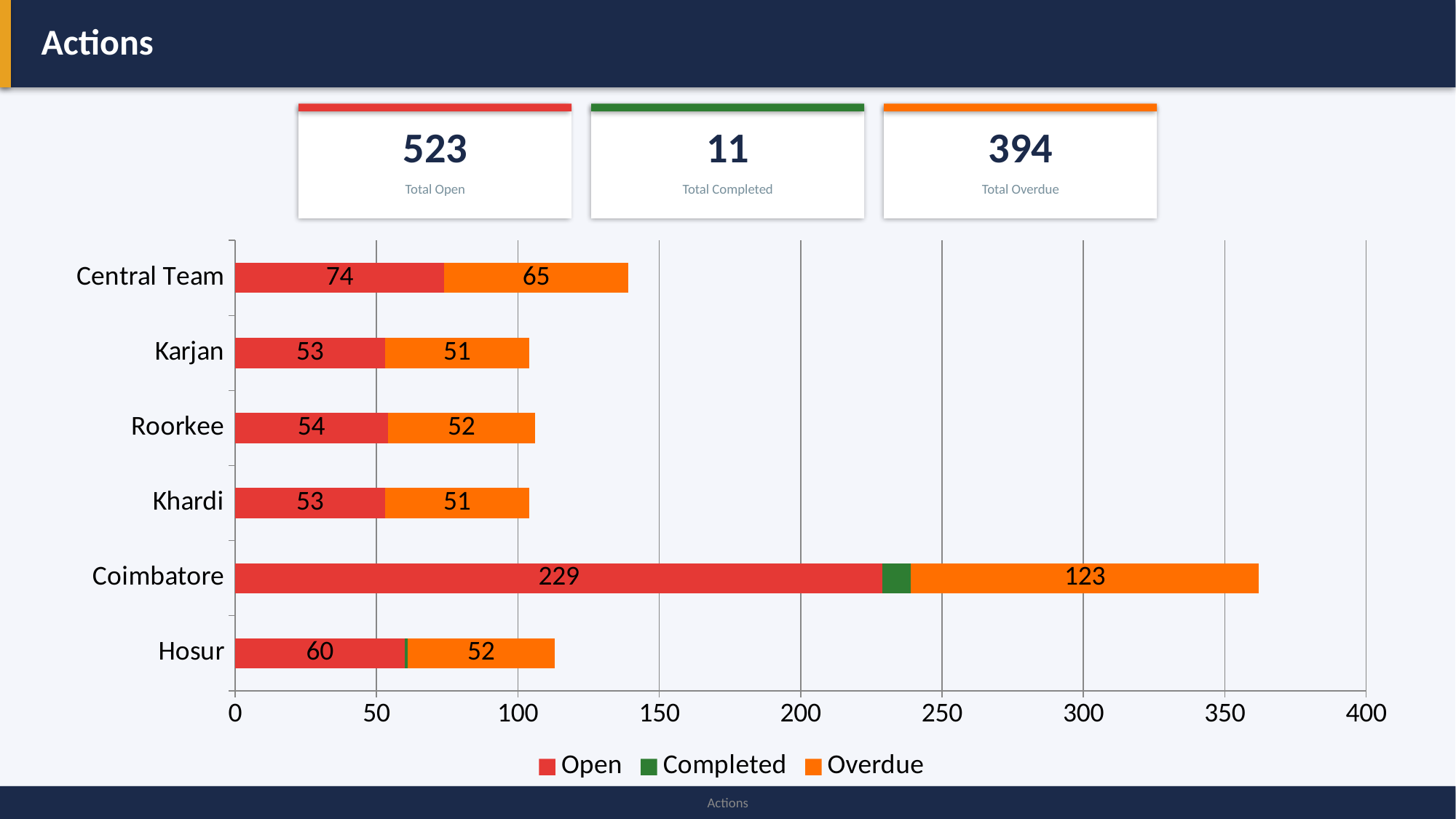
How many series does the legend list? 3 Which is larger, the Open value for Central Team or the Open value for Hosur? Central Team What is the difference between the Open and Overdue values for Coimbatore? 106 Which category has the highest Open value? Coimbatore What is the Overdue value for Central Team? 65 What kind of chart is shown on the slide? Stacked bar chart How much larger is the Open value for Central Team than the Open value for Karjan? 21 How many categories are shown on the chart? 6 Which category has the highest Overdue value? Coimbatore Is the total length of the Coimbatore bar greater or less than 350? greater What is the Open value for Coimbatore? 229 What is the Open value for Hosur? 60